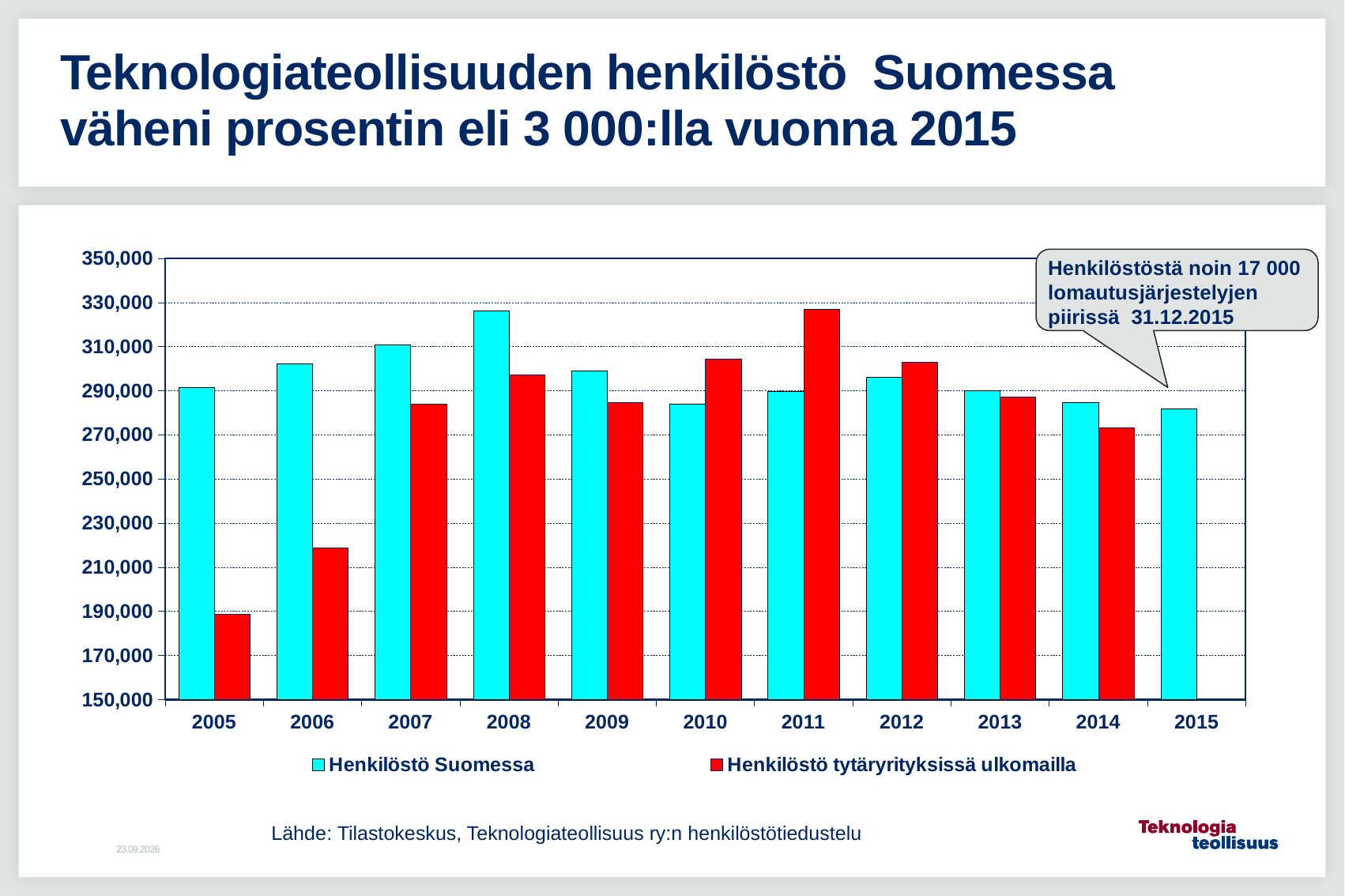
Does the value for Henkilöstö Suomessa rise or fall from 2012 to 2015? fall In which year is the value for Henkilöstö Suomessa highest? 2008 What kind of chart is shown on the slide? bar chart In which year is the value for Henkilöstö tytäryrityksissä ulkomailla highest? 2011 In 2011, which series has the larger value: Henkilöstö Suomessa or Henkilöstö tytäryrityksissä ulkomailla? Henkilöstö tytäryrityksissä ulkomailla Is the value for Henkilöstö Suomessa in 2015 greater or less than 290,000? less Is the value for Henkilöstö Suomessa in 2008 greater or less than 310,000? greater How many series does the legend list? 2 Is the value for Henkilöstö tytäryrityksissä ulkomailla in 2005 greater or less than 210,000? less How many years are shown on the x axis? 11 In 2005, which series has the larger value: Henkilöstö Suomessa or Henkilöstö tytäryrityksissä ulkomailla? Henkilöstö Suomessa In which year is the value for Henkilöstö tytäryrityksissä ulkomailla lowest? 2005